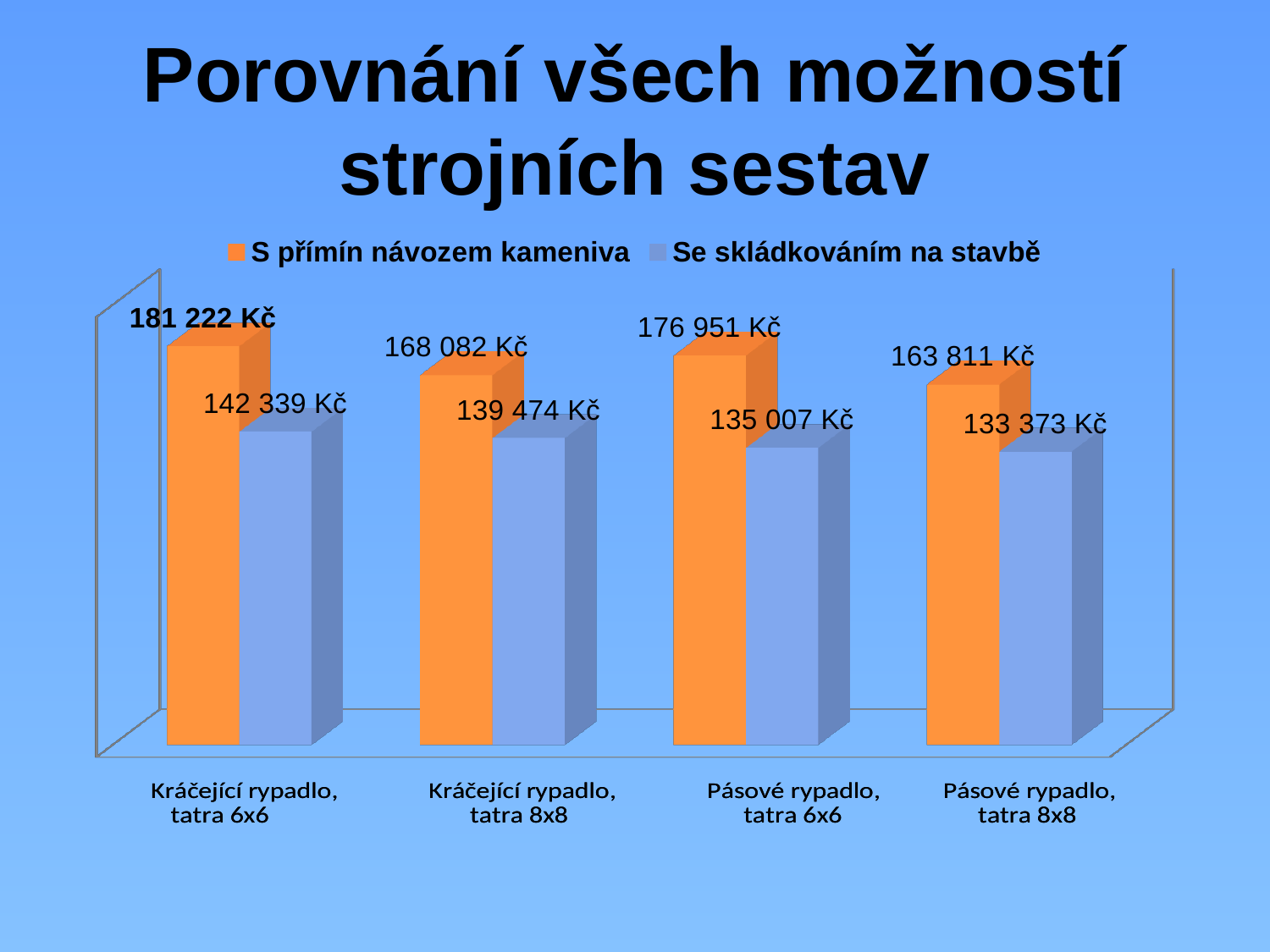
What is the difference between the two series for Pásové rypadlo, tatra 6x6? 41 944 Kč Which category has the highest value in the series S přímín návozem kameniva? Kráčející rypadlo, tatra 6x6 What is the value for Kráčející rypadlo, tatra 6x6 in the series S přímín návozem kameniva? 181 222 Kč What is the value for Pásové rypadlo, tatra 6x6 in the series S přímín návozem kameniva? 176 951 Kč How many series does the legend list? 2 What is the difference between the two series for Kráčející rypadlo, tatra 6x6? 38 883 Kč How many categories are shown on the x axis? 4 What is the value for Pásové rypadlo, tatra 8x8 in the series Se skládkováním na stavbě? 133 373 Kč What kind of chart is shown on the slide? Bar chart What is the value for Kráčející rypadlo, tatra 8x8 in the series Se skládkováním na stavbě? 139 474 Kč Which category has the lowest value in the series Se skládkováním na stavbě? Pásové rypadlo, tatra 8x8 Which is larger in the series S přímín návozem kameniva: Kráčející rypadlo, tatra 8x8 or Pásové rypadlo, tatra 6x6? Pásové rypadlo, tatra 6x6